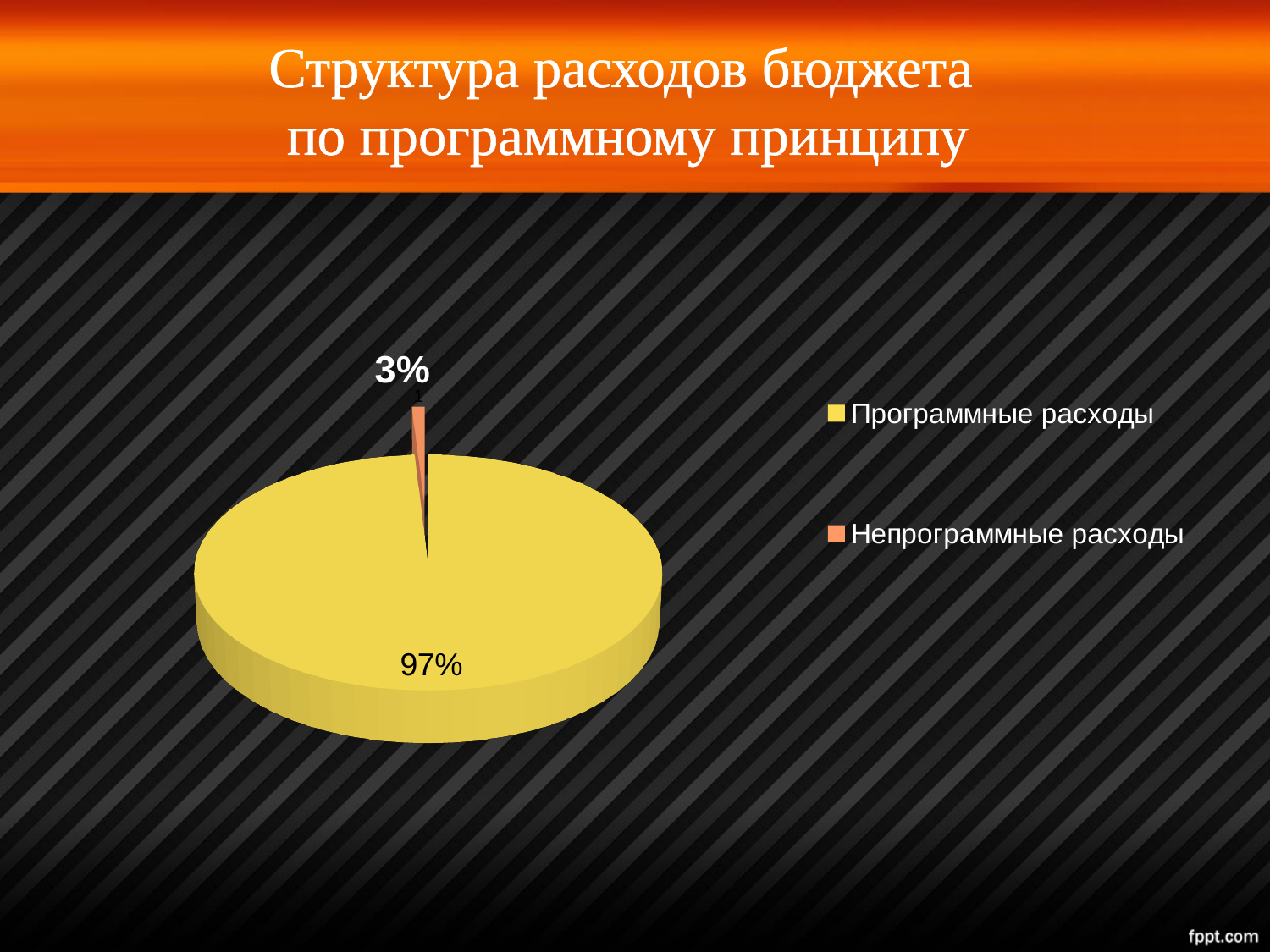
Which category has the largest slice of the pie? Программные расходы Which category has the smallest slice of the pie? Непрограммные расходы How many slices does the pie chart have? 2 Which is larger: the share for Программные расходы or for Непрограммные расходы? Программные расходы What share of the pie is labelled for Программные расходы? 97% What share of the pie is labelled for Непрограммные расходы? 3% What is the difference in percentage points between Программные расходы and Непрограммные расходы? 94 What is the title of the slide containing the pie chart? Структура расходов бюджета по программному принципу What kind of chart is shown on the slide? pie chart How many entries does the legend list? 2 What colour is the slice for Непрограммные расходы? orange